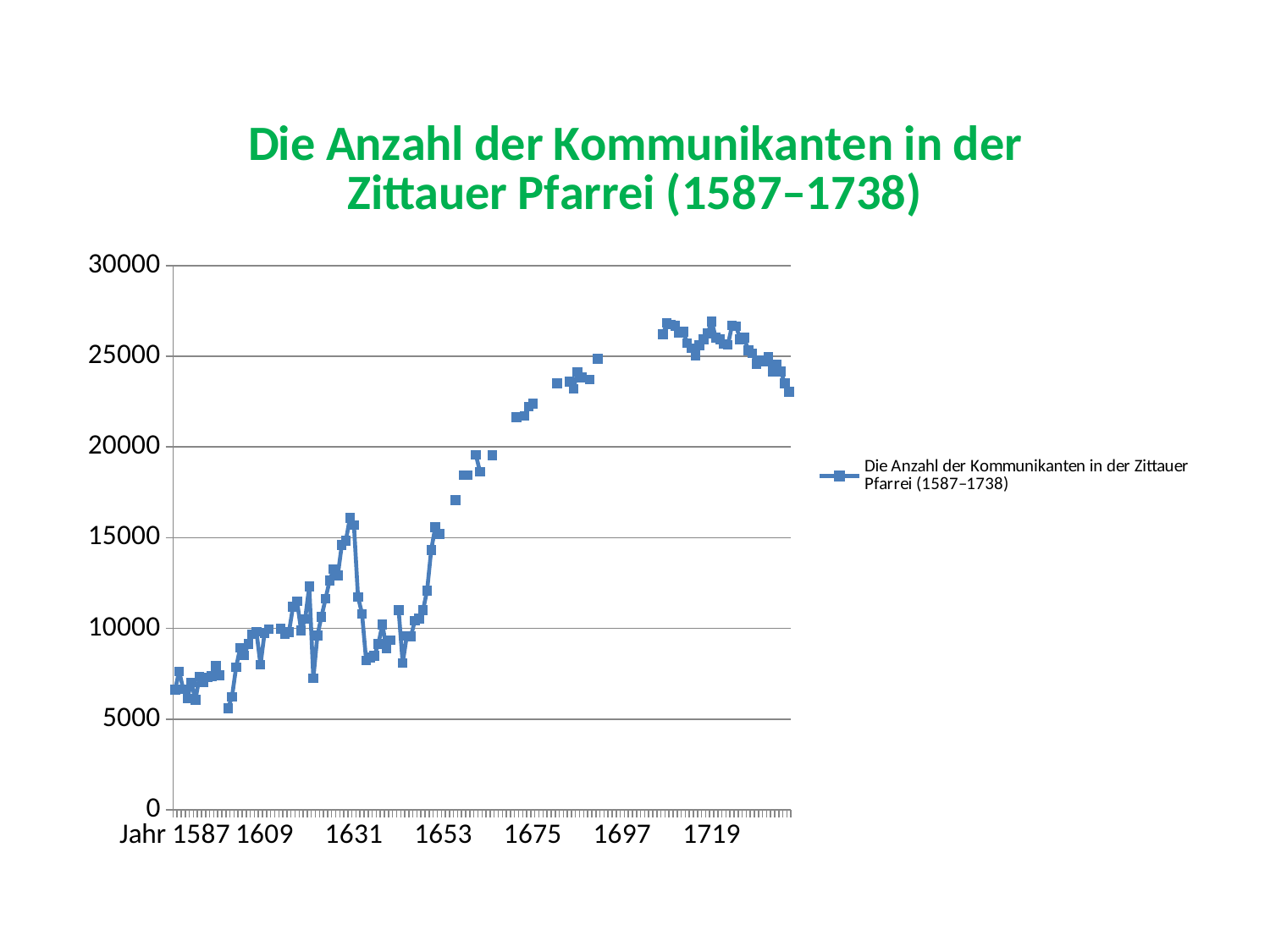
Is the value for 1719 greater or less than 20000? greater Is the value for 1675 greater or less than 20000? greater Is the highest value plotted on the chart greater or less than 25000? greater Do the values generally rise or fall from 1587 to 1697? rise How many series does the legend list? 1 What kind of chart is shown on the slide? line chart Which year has the larger value, 1587 or 1719? 1719 What is the title of the chart? Die Anzahl der Kommunikanten in der Zittauer Pfarrei (1587–1738) What is the first year label shown on the x axis after "Jahr"? 1587